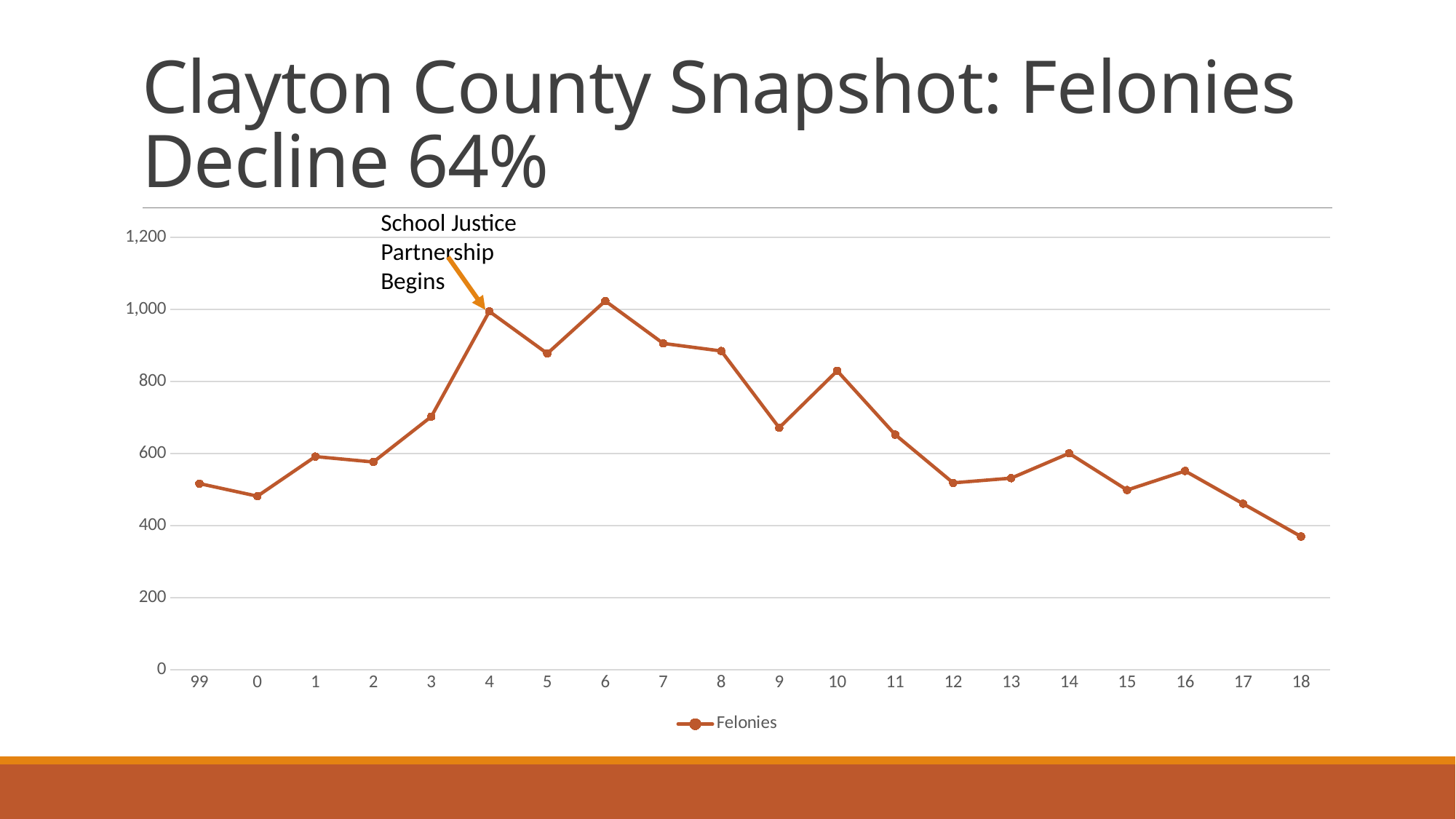
What kind of chart is shown on the slide? line chart How many series does the legend list? 1 Is the value for year 10 greater or less than 800? greater What event does the annotation arrow at year 4 mark? School Justice Partnership Begins Is the value for year 6 greater or less than 1,000? greater Do the felony values rise or fall from year 10 to year 12? fall Which year label on the x axis has the lowest number of felonies? 18 Which has more felonies, year 9 or year 10? 10 How many data points are plotted on the line? 20 What is the name of the series shown in the legend? Felonies Which year label on the x axis has the highest number of felonies? 6 Is the value for year 18 greater or less than 400? less